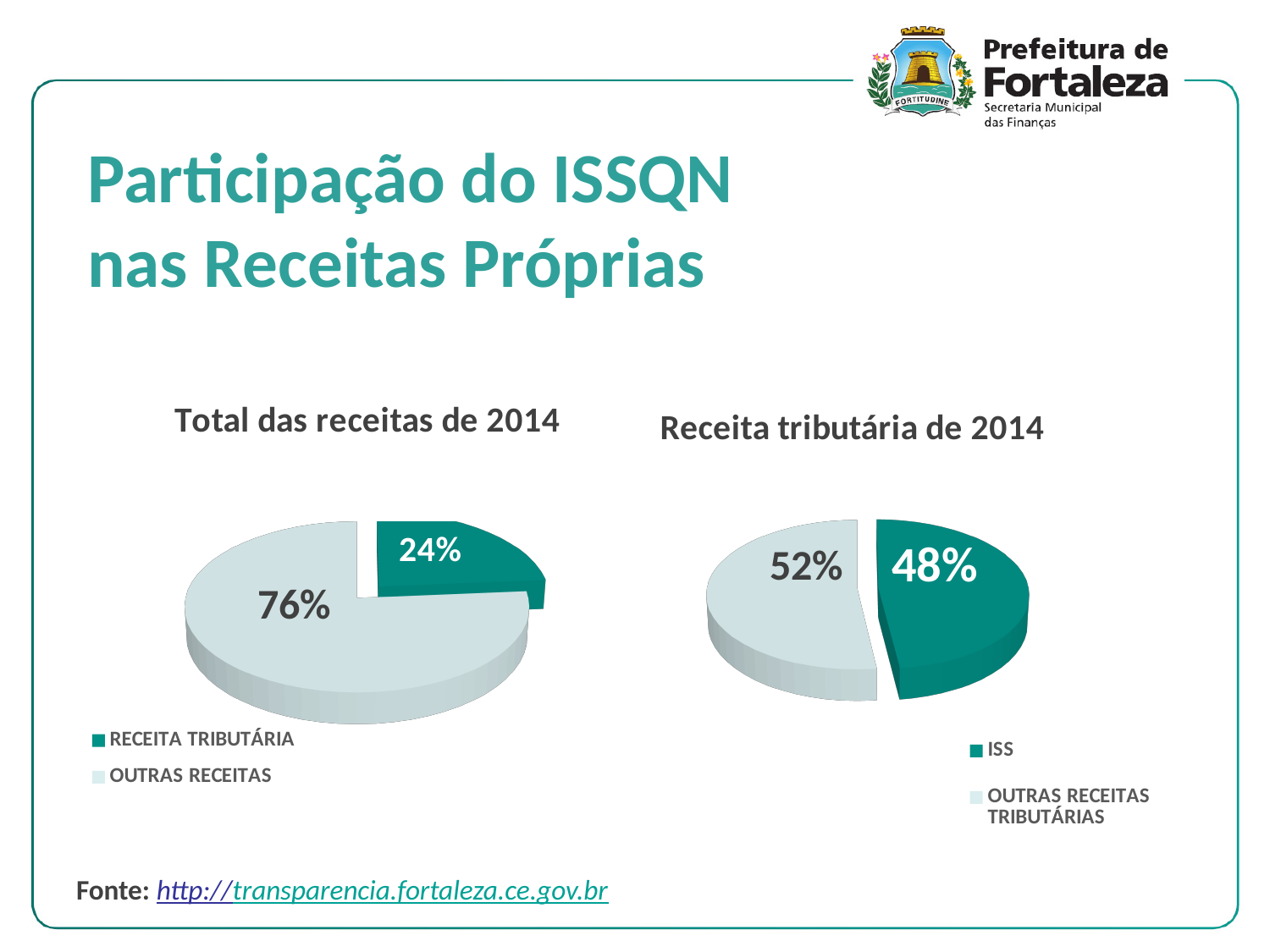
In the 'Total das receitas de 2014' chart, what share does OUTRAS RECEITAS have? 76% In the 'Receita tributária de 2014' chart, which is larger: ISS or OUTRAS RECEITAS TRIBUTÁRIAS? OUTRAS RECEITAS TRIBUTÁRIAS In the 'Receita tributária de 2014' chart, which slice is the smallest? ISS In the 'Total das receitas de 2014' chart, which slice is the largest? OUTRAS RECEITAS In the 'Receita tributária de 2014' chart, what share does OUTRAS RECEITAS TRIBUTÁRIAS have? 52% In the 'Receita tributária de 2014' chart, what is the difference between the OUTRAS RECEITAS TRIBUTÁRIAS share and the ISS share? 4% In the 'Receita tributária de 2014' chart, what share does ISS have? 48% How many slices does the 'Receita tributária de 2014' chart have? 2 In the 'Total das receitas de 2014' chart, what is the difference between the OUTRAS RECEITAS share and the RECEITA TRIBUTÁRIA share? 52% How many entries does the legend of the 'Total das receitas de 2014' chart list? 2 What kind of chart is the 'Total das receitas de 2014' chart? Pie chart